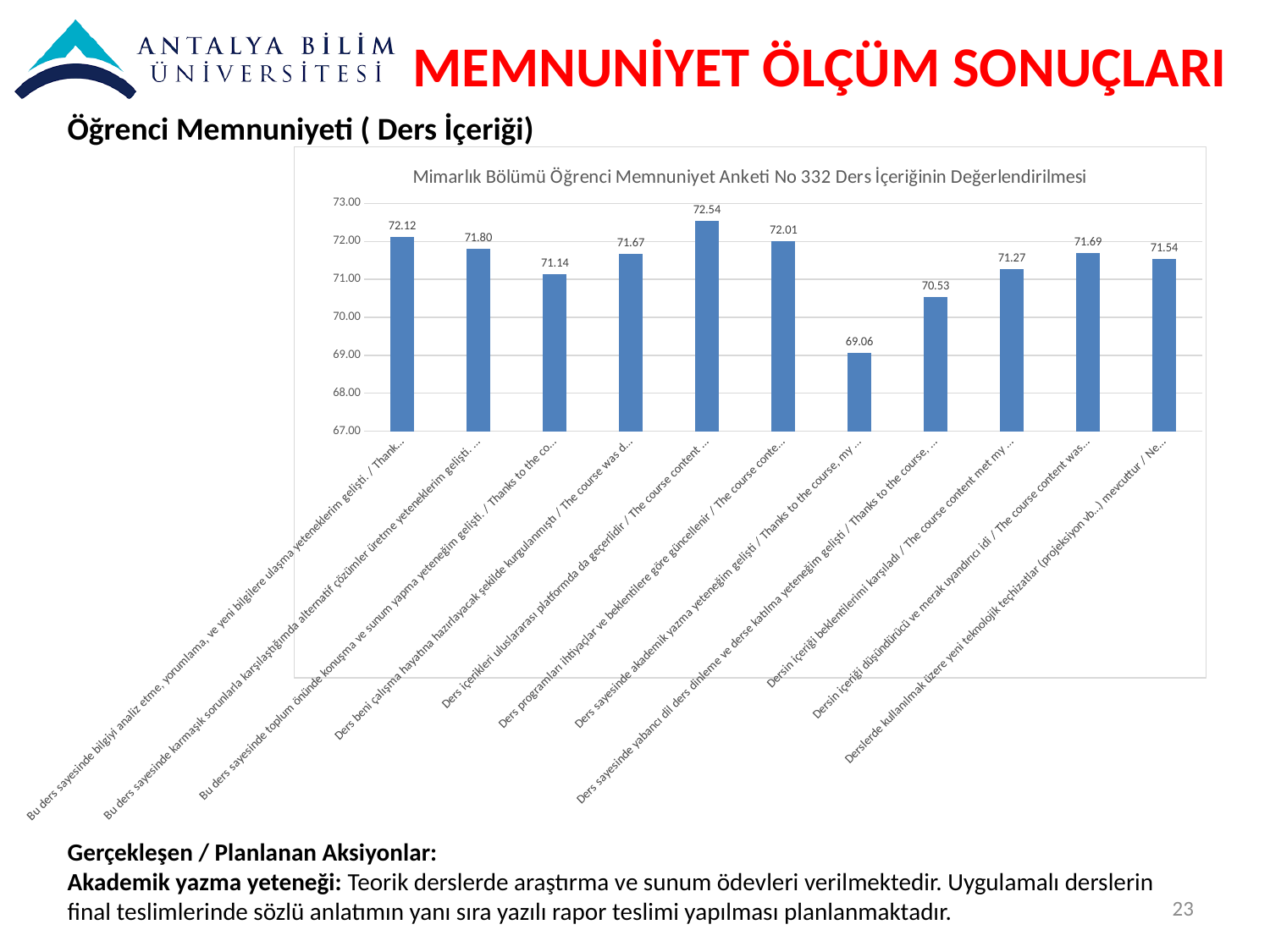
What is the value of the bar for 'Dersin içeriği beklentilerimi karşıladı / The course content met my ...'? 71.27 What is the value of the last bar (Derslerde kullanılmak üzere yeni teknolojik teçhizatlar...)? 71.54 What is the title of the chart? Mimarlık Bölümü Öğrenci Memnuniyet Anketi No 332 Ders İçeriğinin Değerlendirilmesi How many bars are plotted in the chart? 11 What is the lowest value shown in the chart? 69.06 Which is larger: the value for 'Ders programları ihtiyaçlar ve beklentilere göre güncellenir...' (72.01) or the value for 'Ders beni çalışma hayatına hazırlayacak şekilde kurgulanmıştı...' (71.67)? Ders programları ihtiyaçlar ve beklentilere göre güncellenir... (72.01) What is the difference between the highest value (72.54) and the lowest value (69.06) in the chart? 3.48 What type of chart is shown on the slide? bar chart What is the value of the first bar (Bu ders sayesinde bilgiyi analiz etme, yorumlama...)? 72.12 Is the value for 'Ders sayesinde yabancı dil ders dinleme ve derse katılma yeteneğim gelişti...' greater or less than 71.00? less What is the highest value shown in the chart? 72.54 What is the value of the bar for 'Ders sayesinde akademik yazma yeteneğim gelişti / Thanks to the course, my ...'? 69.06